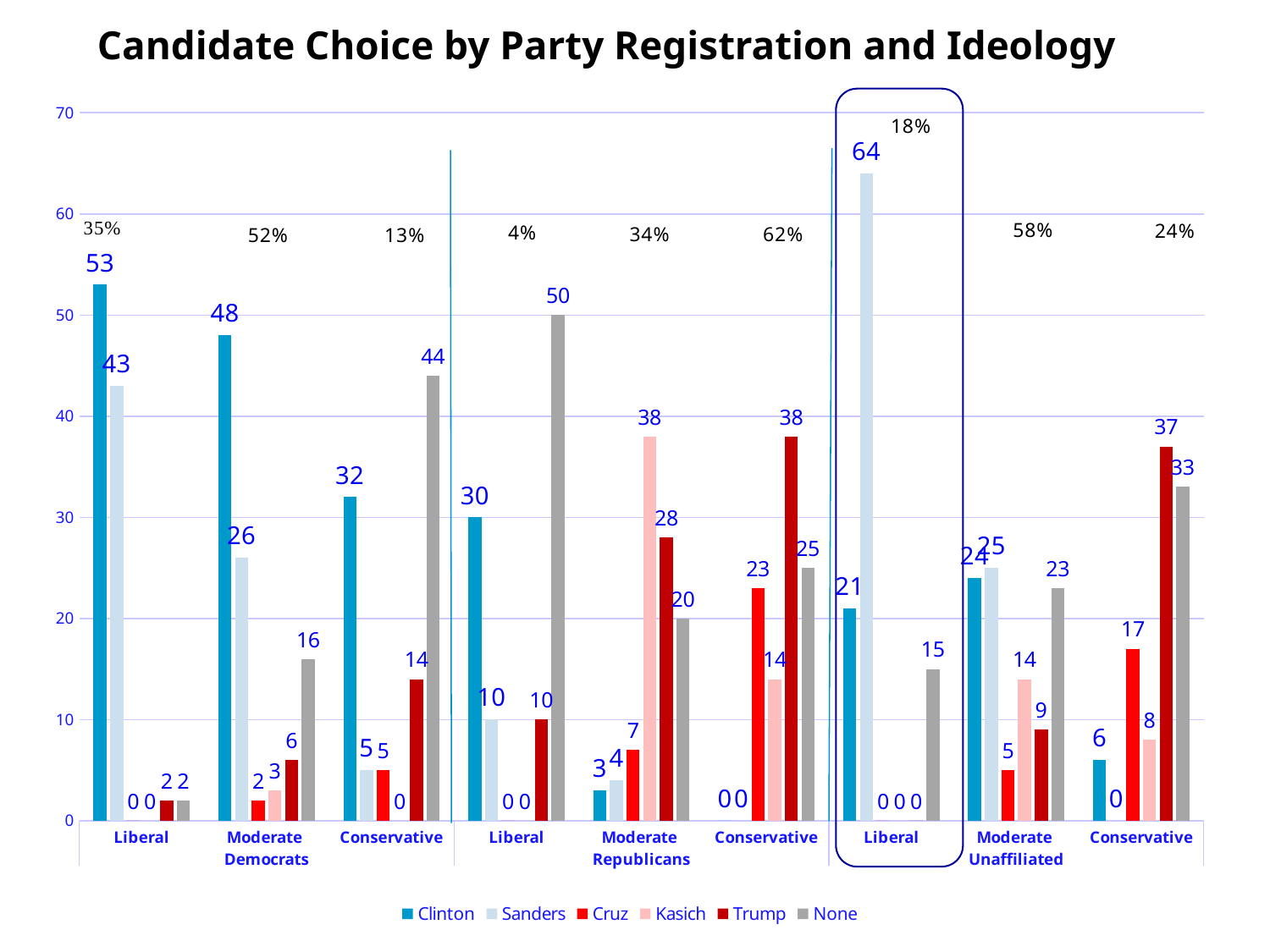
Which candidate has the highest value among Conservative Republicans? Trump Which candidate has the highest value among Liberal Republicans? None How many series does the legend list? 6 What is the difference between Clinton and Sanders among Moderate Democrats? 22 What kind of chart is shown on the slide? Bar chart What is the value for None among Conservative Democrats? 44 Which is larger among Conservative Unaffiliated voters: Trump or None? Trump What is the value for Sanders among Liberal Unaffiliated voters? 64 What is the value for Kasich among Moderate Republicans? 38 What is the title of the chart? Candidate Choice by Party Registration and Ideology How many ideology categories are shown along the x axis? 9 What is the value for Clinton among Liberal Democrats? 53